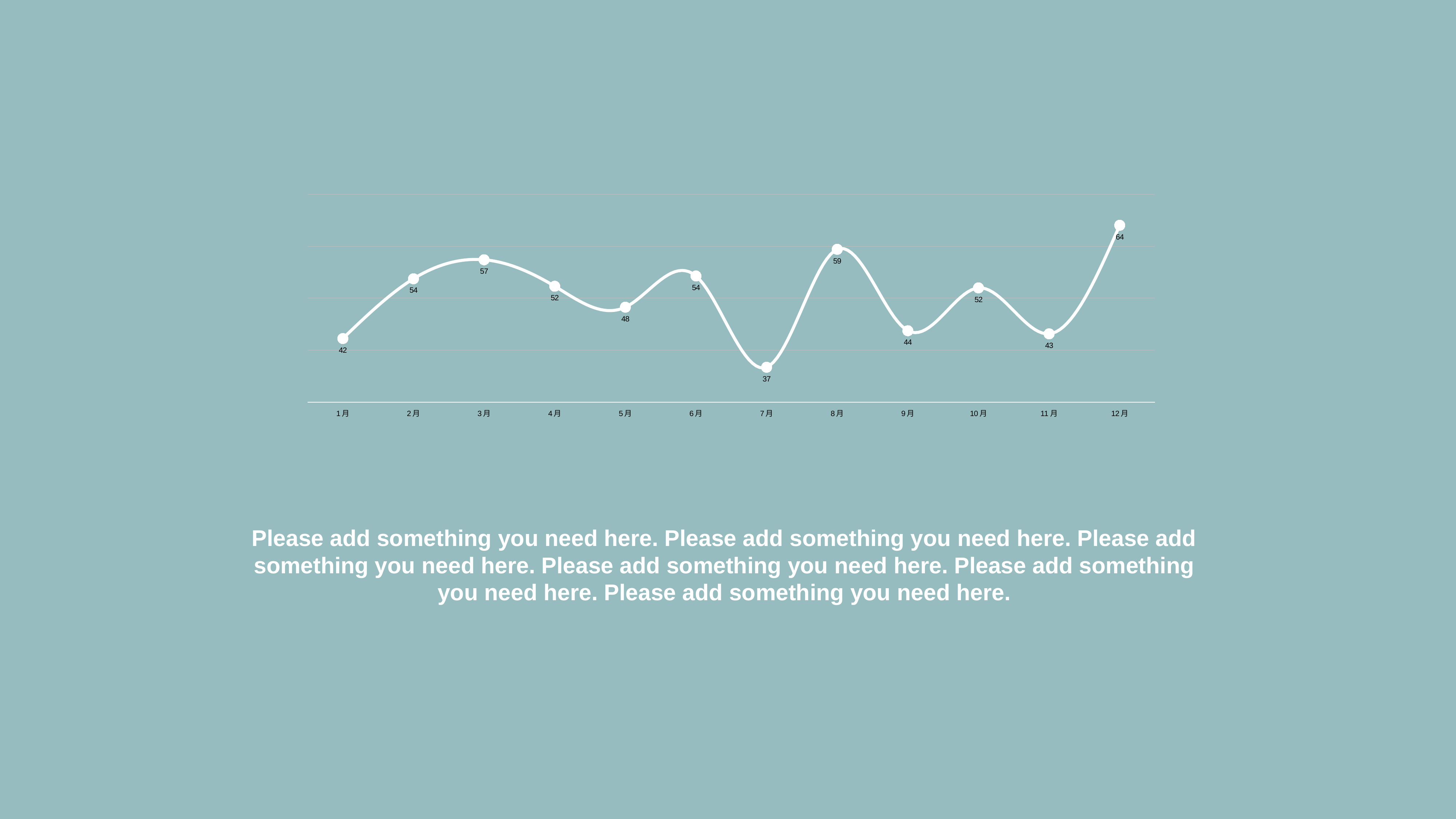
How many months are plotted on the chart? 12 Which month has the lowest value? 7月 What is the value for 3月? 57 Which is larger, the value for 2月 or the value for 11月? 2月 Does the value rise or fall from 6月 to 7月? fall What is the value for 10月? 52 What is the value for 7月? 37 Which month has the highest value? 12月 What kind of chart is shown on the slide? line chart What is the difference between the values for 12月 and 1月? 22 What is the difference between the values for 8月 and 9月? 15 What colour is the line on the chart? white